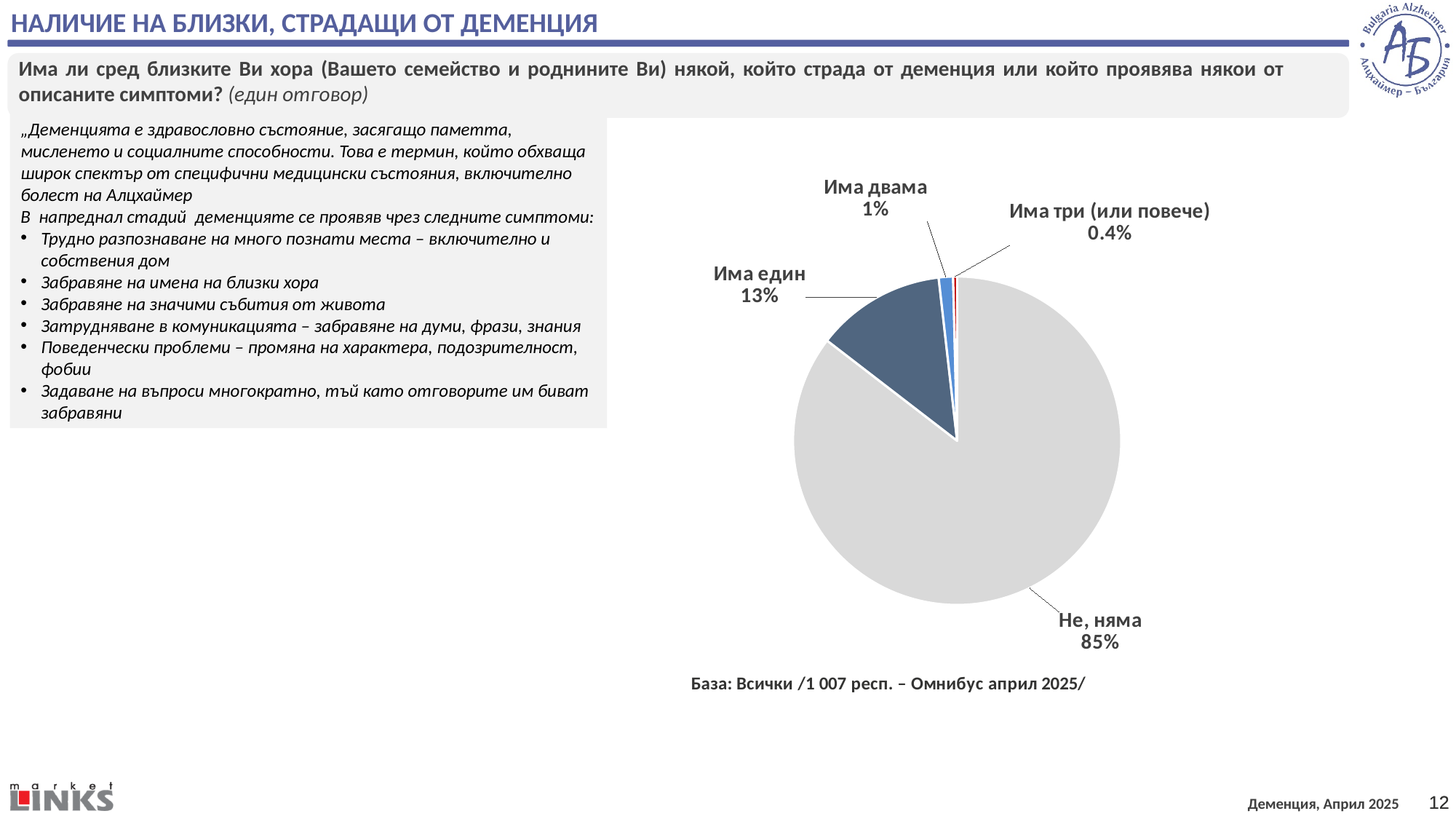
What is the difference in percentage points between "Не, няма" and "Има един"? 72 percentage points What is the base (number of respondents) stated below the chart? 1 007 респ. What kind of chart is shown on the slide? Pie chart Which category has the largest slice of the pie? Не, няма What share of respondents answered "Има три (или повече)"? 0.4% What share of respondents answered "Има един"? 13% Which category has the smallest slice of the pie? Има три (или повече) What colour is the slice for "Не, няма"? Light grey What share of respondents answered "Не, няма"? 85% How many categories are shown in the pie chart? 4 Which is larger: the share for "Има един" or the share for "Има двама"? Има един What share of respondents answered "Има двама"? 1%